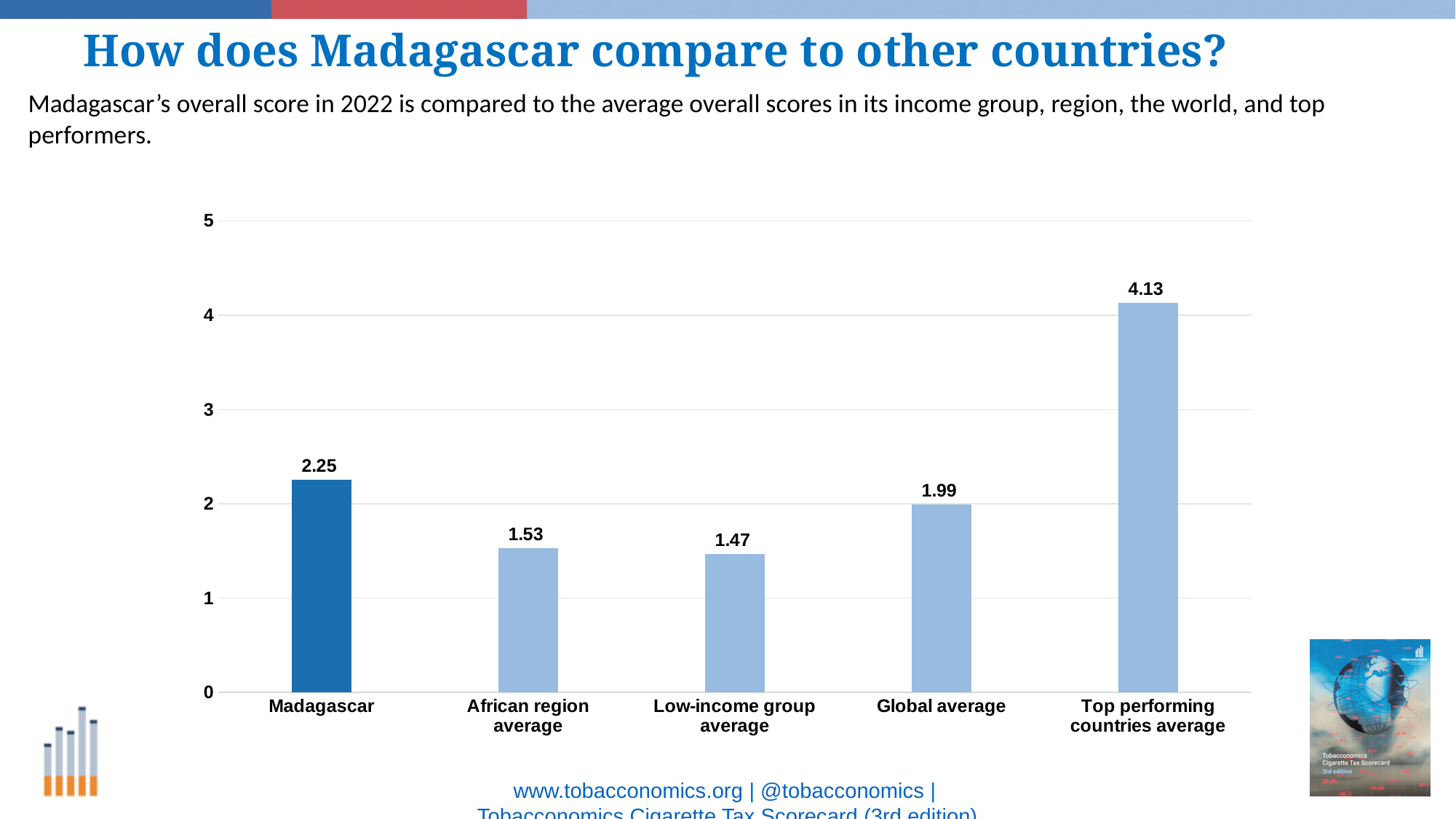
What is the value shown for Madagascar? 2.25 Which category has the highest value? Top performing countries average How many categories are shown on the chart? 5 Is the value for the Top performing countries average greater or less than 4? greater What is the value shown for the Global average? 1.99 Which category has the lowest value? Low-income group average What is the difference between the Top performing countries average and Madagascar? 1.88 What kind of chart is shown on the slide? bar chart Which is larger, Madagascar or the Global average? Madagascar What is the difference between Madagascar and the African region average? 0.72 Which bar is shown in a darker blue than the others? Madagascar What is the value shown for the Top performing countries average? 4.13